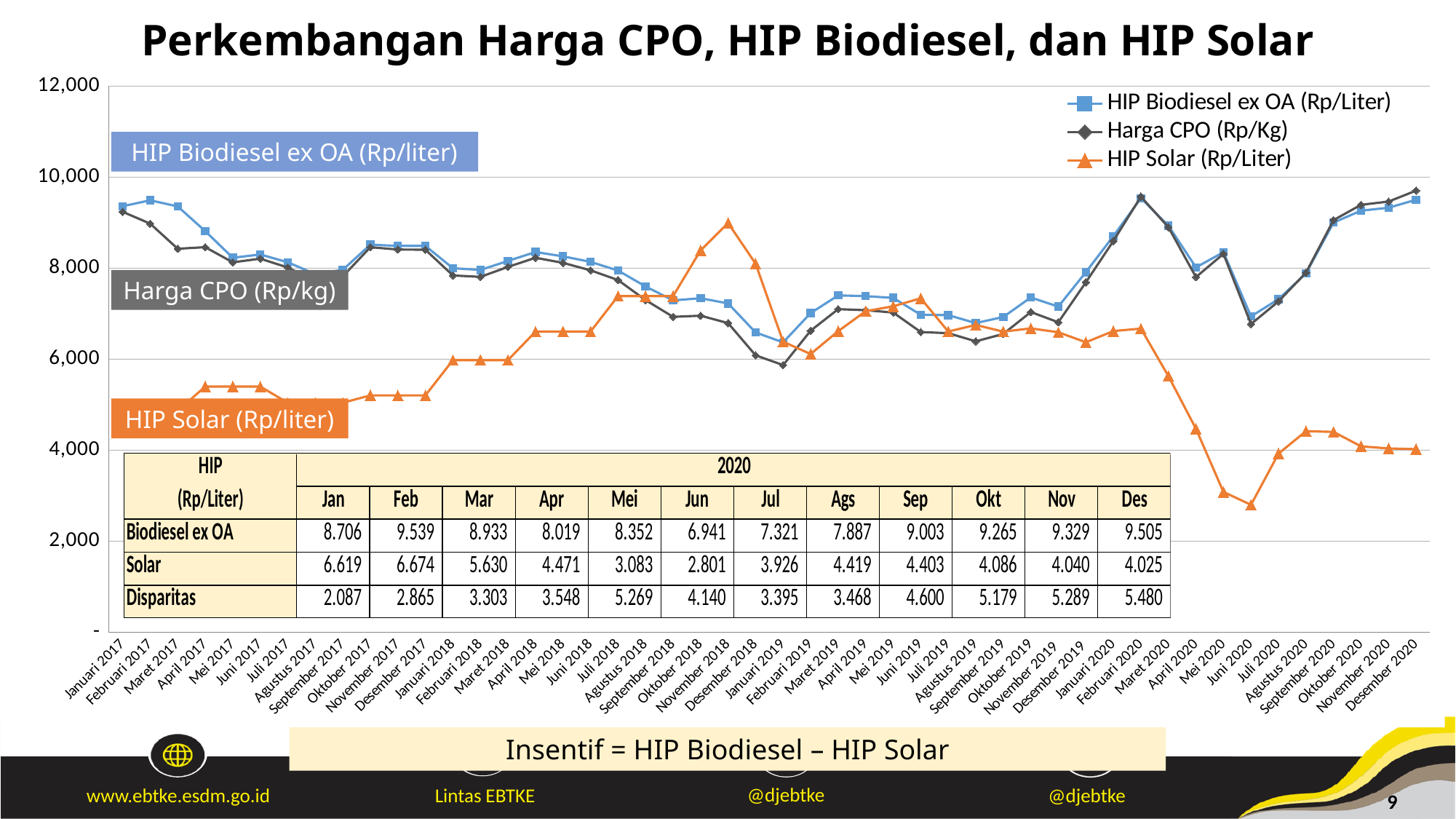
According to the table, what was the HIP Biodiesel ex OA value in Jan 2020? 8.706 Does the HIP Solar line rise or fall from Februari 2020 to Juni 2020? fall What kind of chart is shown on the slide? line chart How many series does the chart legend list? 3 In Mei 2020, which is larger according to the table: Biodiesel ex OA or Solar? Biodiesel ex OA In the 2020 table, which month has the highest Biodiesel ex OA value? Feb Is the HIP Solar value for Januari 2017 greater or less than 6,000? less What is the difference between the Biodiesel ex OA and Solar values for Des 2020 in the table? 5.480 Is the HIP Biodiesel ex OA value for Februari 2017 greater or less than 8,000? greater According to the table, what was the HIP Solar value in Jun 2020? 2.801 In the 2020 table, which month has the lowest Solar value? Jun Which series is drawn with orange triangle markers? HIP Solar (Rp/Liter)